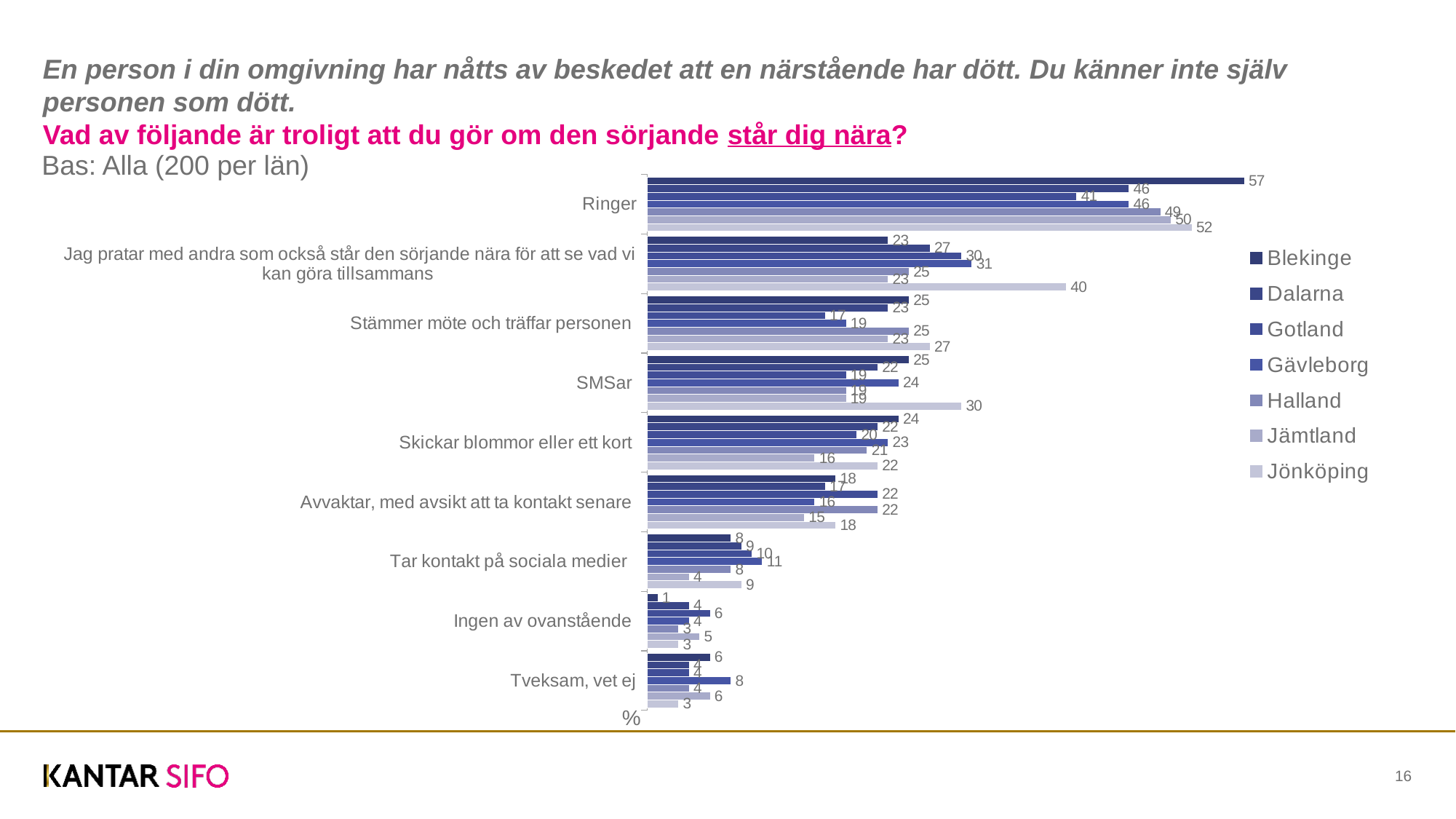
How many response categories are shown on the chart? 9 How many series does the legend list? 7 What is the value for Jönköping in the "Jag pratar med andra som också står den sörjande nära för att se vad vi kan göra tillsammans" category? 40 What is the value for Blekinge in the "Ringer" category? 57 Which county has the highest value in the "Ringer" category? Blekinge What is the value for Blekinge in the "Ingen av ovanstående" category? 1 What is the difference between Blekinge and Gotland in the "Ringer" category? 16 In the "SMSar" category, which is larger: Jönköping or Blekinge? Jönköping Which county is listed first in the legend? Blekinge What kind of chart is shown on the slide? Bar chart What is the value for Jämtland in the "Tar kontakt på sociala medier" category? 4 Which county has the lowest value in the "Ringer" category? Gotland